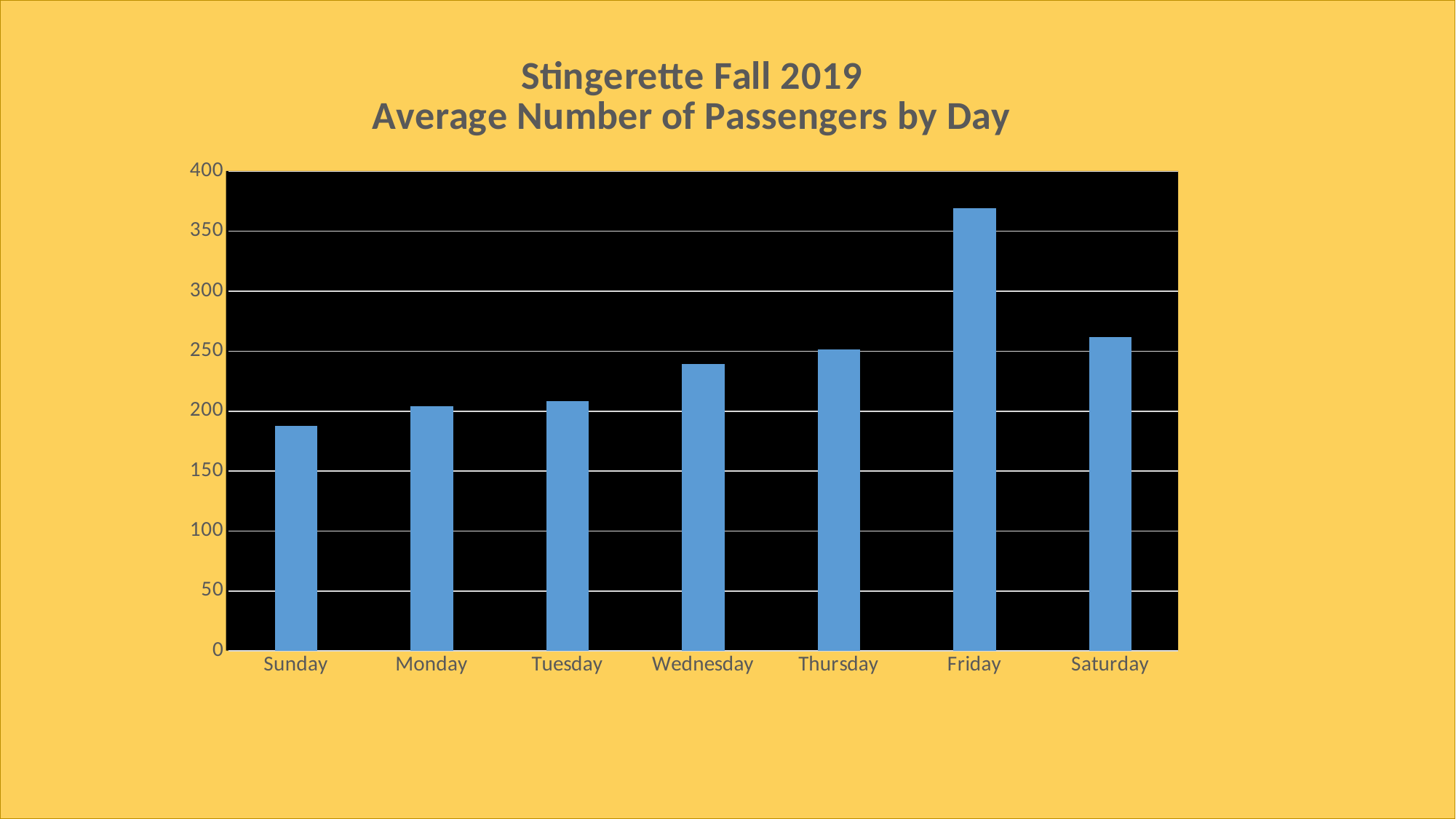
What kind of chart is shown on the slide? bar chart Which day has the lowest average number of passengers? Sunday Is the value for Sunday greater or less than 200? less Is the value for Wednesday greater or less than 250? less What is the title of the chart? Stingerette Fall 2019 Average Number of Passengers by Day Is the value for Saturday greater or less than 250? greater Which has a higher average number of passengers, Sunday or Wednesday? Wednesday Which has a higher average number of passengers, Friday or Saturday? Friday Which day has the highest average number of passengers? Friday Do the values rise or fall from Sunday through Friday? rise How many days are shown on the x axis of the chart? 7